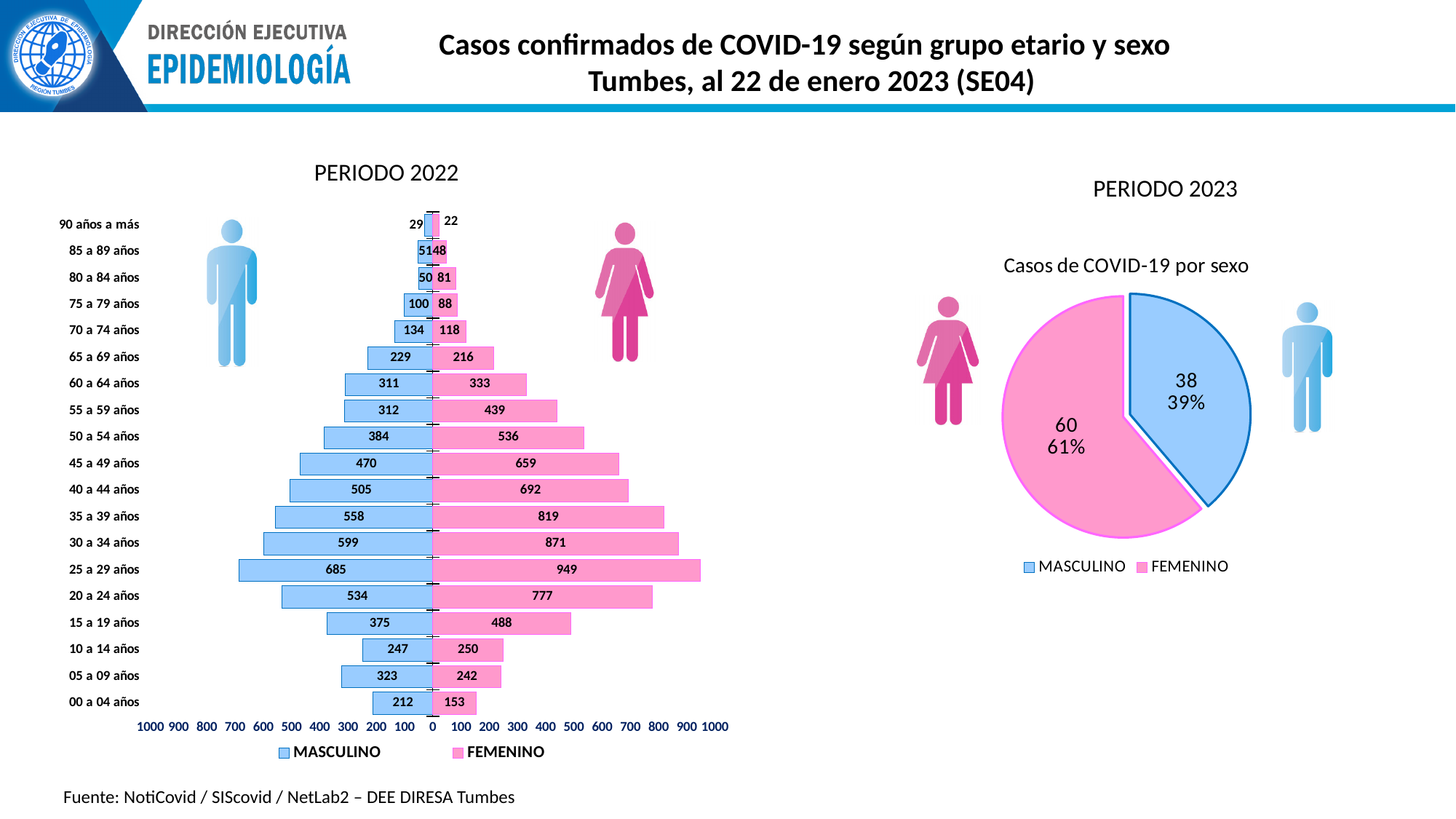
In the PERIODO 2022 chart, which age group has the highest FEMENINO value? 25 a 29 años In the PERIODO 2022 chart, how many age groups are shown? 19 In the PERIODO 2022 chart, how many series does the legend list? 2 In the PERIODO 2022 chart, for the 05 a 09 años group, which series has the larger value, MASCULINO or FEMENINO? MASCULINO In the PERIODO 2022 chart, what is the FEMENINO value for the 25 a 29 años group? 949 What kind of chart is the PERIODO 2022 chart? Bar chart In the PERIODO 2023 pie chart, what is the value for MASCULINO? 38 In the PERIODO 2022 chart, what is the MASCULINO value for the 45 a 49 años group? 470 In the PERIODO 2022 chart, what is the difference between the FEMENINO and MASCULINO values for the 25 a 29 años group? 264 What kind of chart is the PERIODO 2023 chart? Pie chart In the PERIODO 2023 pie chart, what share of cases is FEMENINO? 61% In the PERIODO 2022 chart, which age group has the lowest FEMENINO value? 90 años a más